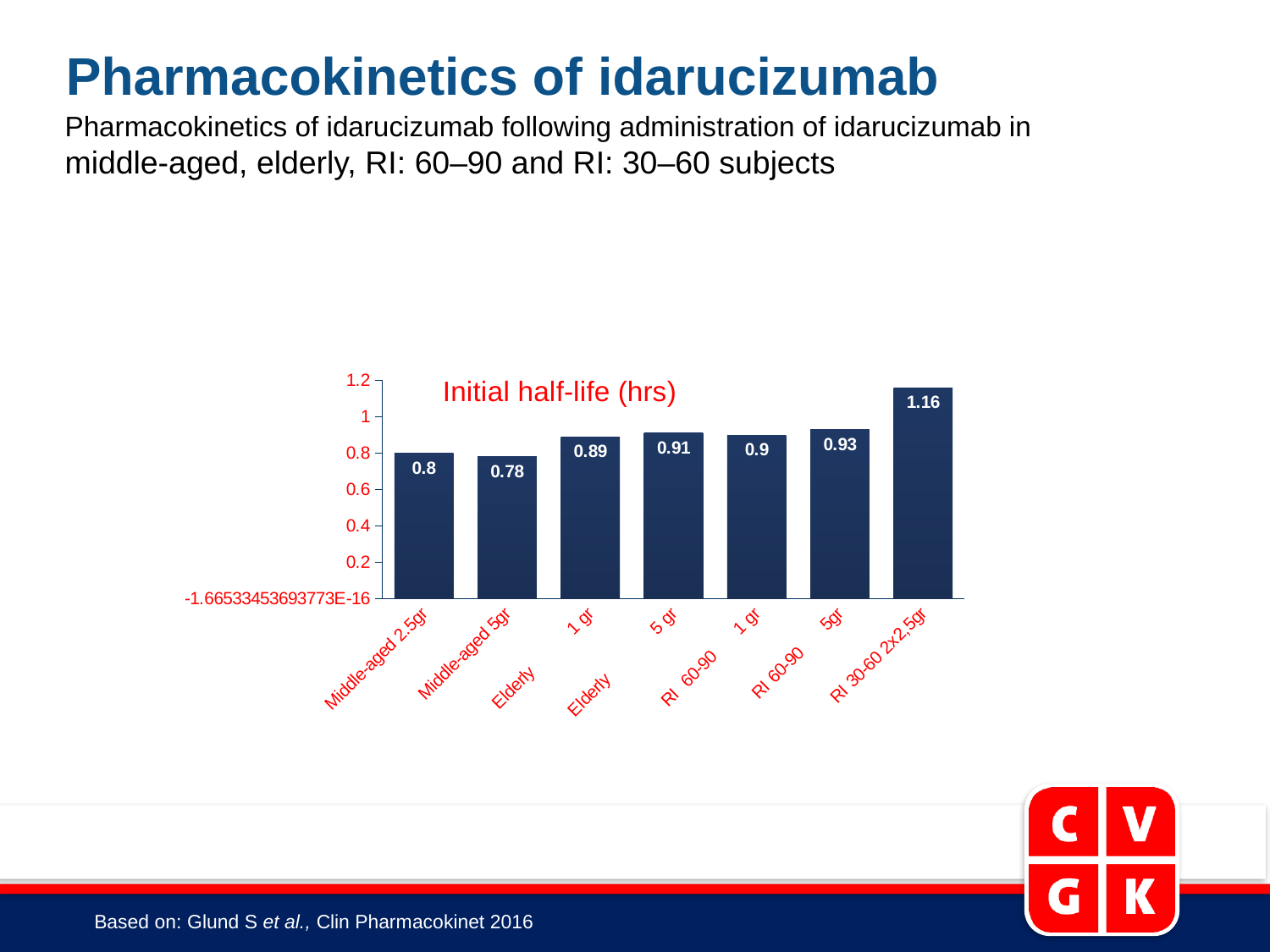
What type of chart is shown on the slide? bar chart What is the difference in initial half-life between RI 30-60 2x2.5gr and Middle-aged 5gr? 0.38 How many bars are shown in the chart? 7 What is the initial half-life (hrs) for Middle-aged 5gr? 0.78 Which category has the lowest initial half-life? Middle-aged 5gr Which category has the highest initial half-life? RI 30-60 2x2.5gr Is the initial half-life for RI 30-60 2x2.5gr greater or less than 1? greater What is the initial half-life (hrs) for RI 30-60 2x2.5gr? 1.16 What is the initial half-life (hrs) for RI 60-90 5gr? 0.93 Which has a larger initial half-life, Elderly 5 gr or Middle-aged 2.5gr? Elderly 5 gr What is the initial half-life (hrs) for Middle-aged 2.5gr? 0.8 What is the title of the chart? Initial half-life (hrs)